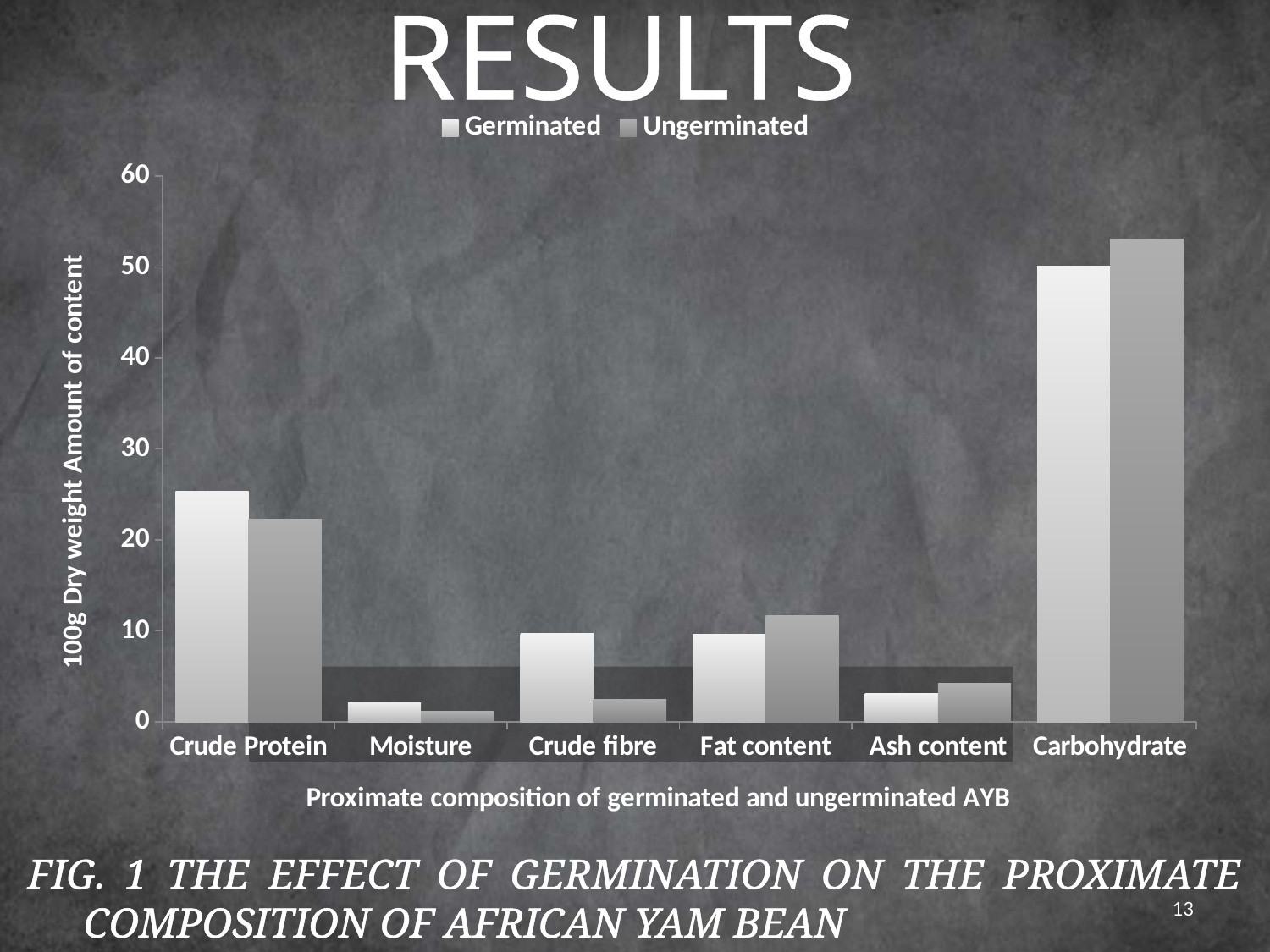
Which category has the highest Germinated value? Carbohydrate What kind of chart is shown on the slide? bar chart For Fat content, which is larger: the Germinated or the Ungerminated value? Ungerminated What is the title of the x axis? Proximate composition of germinated and ungerminated AYB How many series does the legend list? 2 What are the two series named in the legend? Germinated and Ungerminated For Crude Protein, which is larger: the Germinated or the Ungerminated value? Germinated Which category has the lowest Ungerminated value? Moisture Is the Ungerminated value for Carbohydrate greater or less than 50? greater Is the Germinated value for Crude Protein greater or less than 20? greater How many categories are shown on the x axis? 6